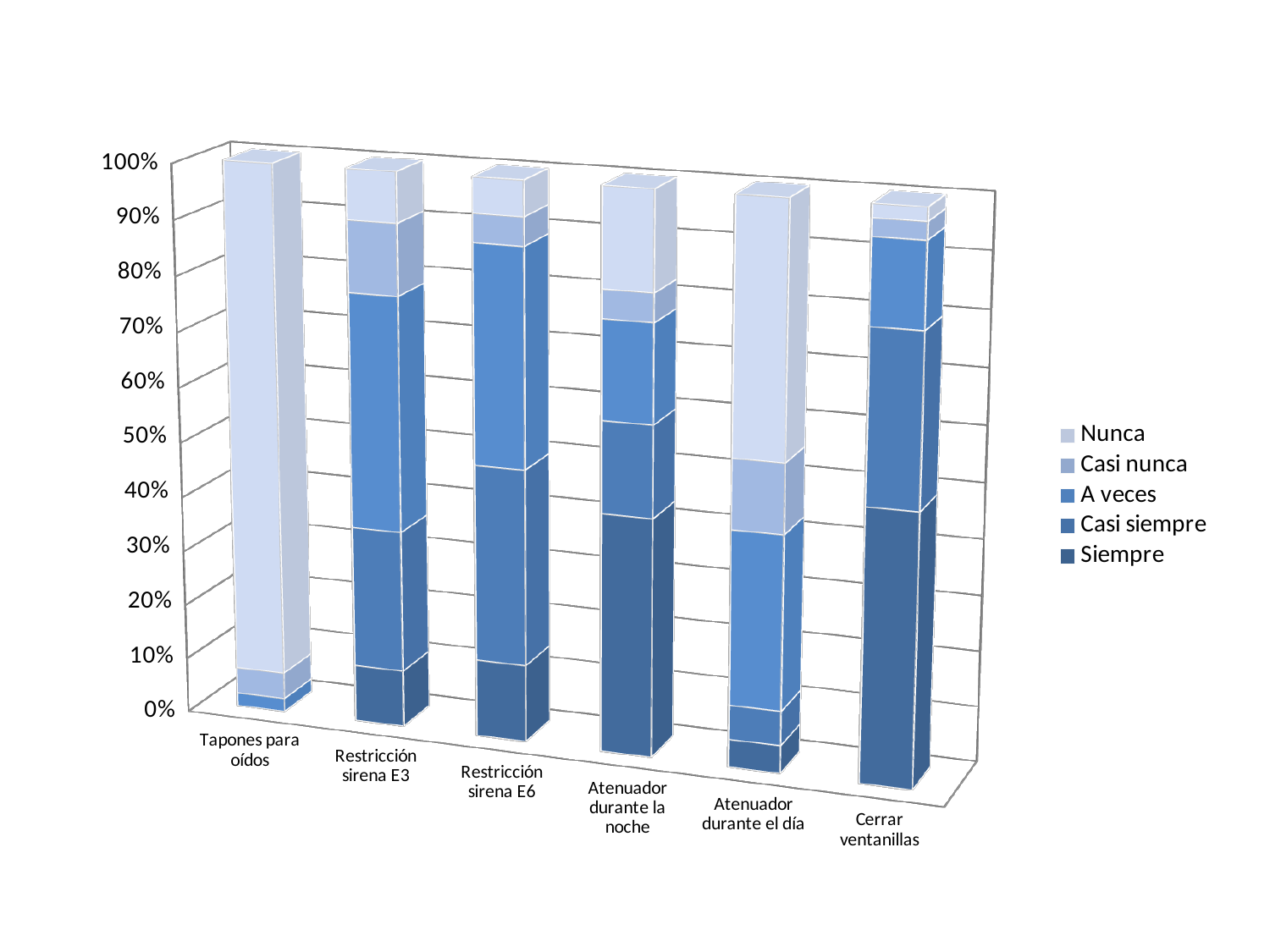
Which has the larger 'Siempre' share: 'Restricción sirena E3' or 'Cerrar ventanillas'? Cerrar ventanillas Which has the larger 'Nunca' share: 'Tapones para oídos' or 'Cerrar ventanillas'? Tapones para oídos How many categories are shown along the x axis? 6 Is the 'Siempre' share for 'Restricción sirena E6' greater or less than 20%? less Which category has the smallest 'Siempre' share? Tapones para oídos How many series does the legend list? 5 Is the 'Siempre' share for 'Cerrar ventanillas' greater or less than 20%? greater Which series is listed last in the legend? Siempre What kind of chart is shown on the slide? Stacked bar chart Which series is listed first in the legend? Nunca Which category has the largest 'Nunca' share? Tapones para oídos Is the 'Nunca' share for 'Tapones para oídos' greater or less than 80%? greater